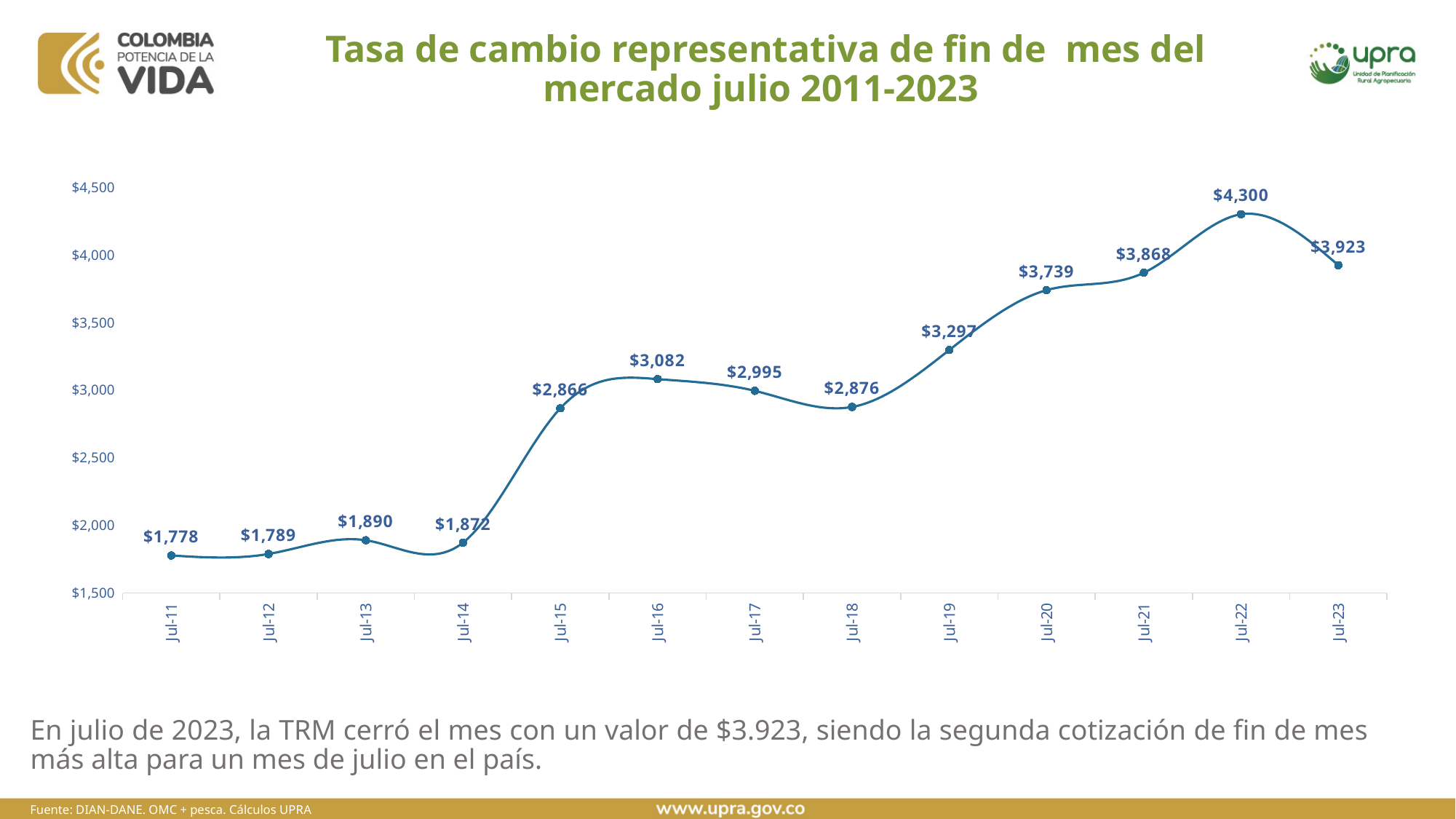
What kind of chart is shown on the slide? line chart Which month has the highest value? Jul-22 What is the value for Jul-11? $1,778 Which is larger, the value for Jul-16 or the value for Jul-17? Jul-16 Do the values generally rise or fall from Jul-11 to Jul-22? rise What is the value for Jul-15? $2,866 What is the difference between the values for Jul-22 and Jul-23? $377 What is the value for Jul-23? $3,923 How many data points are plotted on the chart? 13 What is the difference between the values for Jul-15 and Jul-14? $994 Is the value for Jul-20 greater or less than $3,500? greater Which month has the lowest value? Jul-11